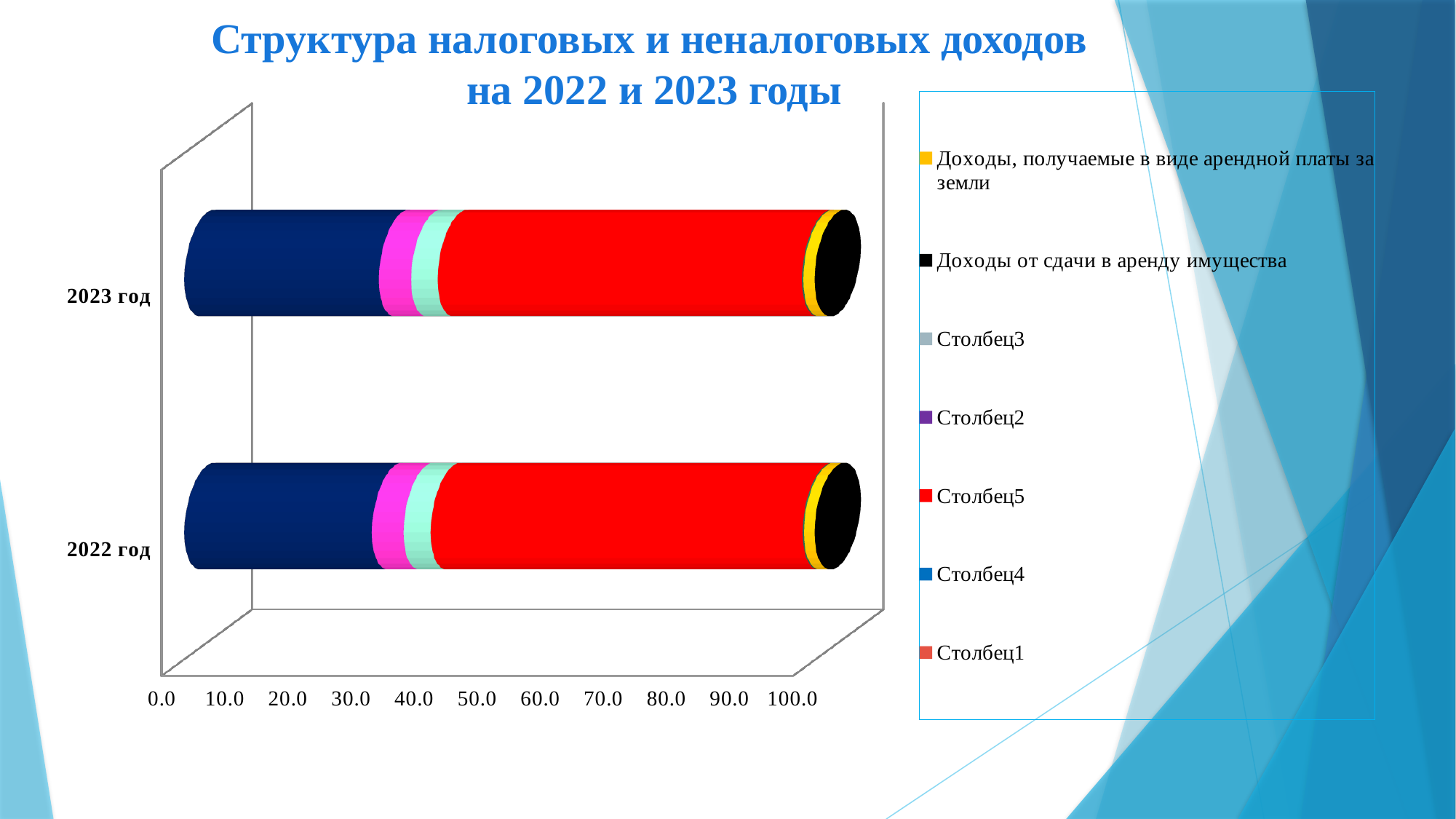
Which legend entry is shown in red? Столбец5 Is the value of the dark blue segment for 2022 год greater or less than 50.0? less What is the highest value shown on the horizontal axis? 100.0 Is the value of the dark blue segment for 2023 год greater or less than 20.0? greater How many series does the legend list? 7 What kind of chart is shown on the slide? Stacked bar chart What is the title of the chart? Структура налоговых и неналоговых доходов на 2022 и 2023 годы Is the value of the red segment for 2023 год greater or less than 40.0? greater How many categories (years) are plotted on the chart? 2